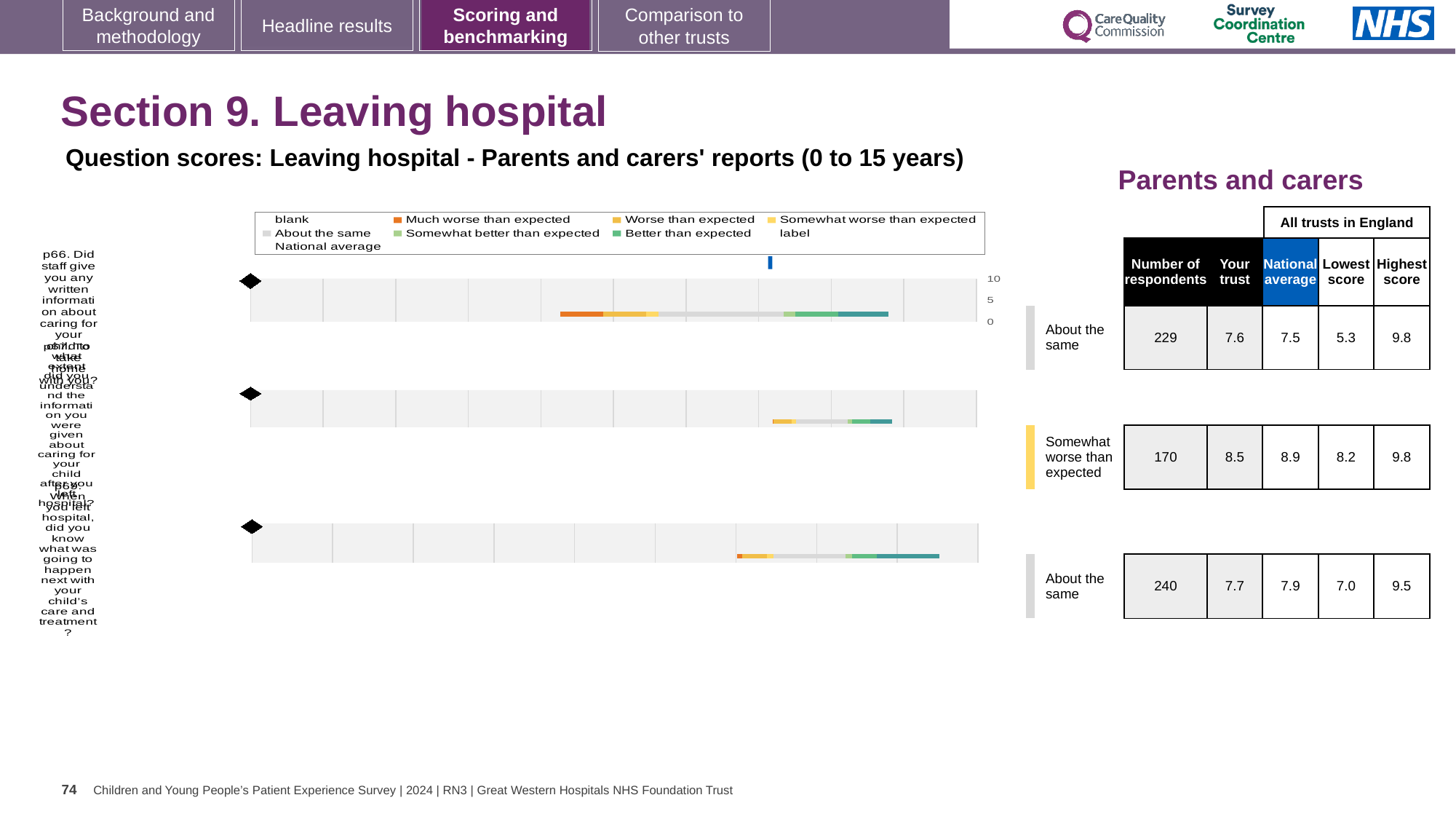
For the second (middle) chart, what is the difference between the national average and the 'Your trust' score? 0.4 How many question charts (rows) are shown on the slide? 3 For the third (bottom) chart, what is the highest score among all trusts in England? 9.5 For the first (top) chart, what is the 'Your trust' score shown in the table? 7.6 Which of the three charts has the highest 'Your trust' score? the second (middle) chart For the third (bottom) chart, what is the difference between the highest score and the lowest score? 2.5 In the legend, what colour represents 'Much worse than expected'? orange What kind of chart is used to show the question scores on this slide? bar chart For the second (middle) chart, what is the national average score shown in the table? 8.9 What benchmark category label is shown next to the second (middle) chart? Somewhat worse than expected For the third (bottom) chart, how many respondents are listed in the table? 240 For the first (top) chart, which is larger: the 'Your trust' score or the national average? Your trust